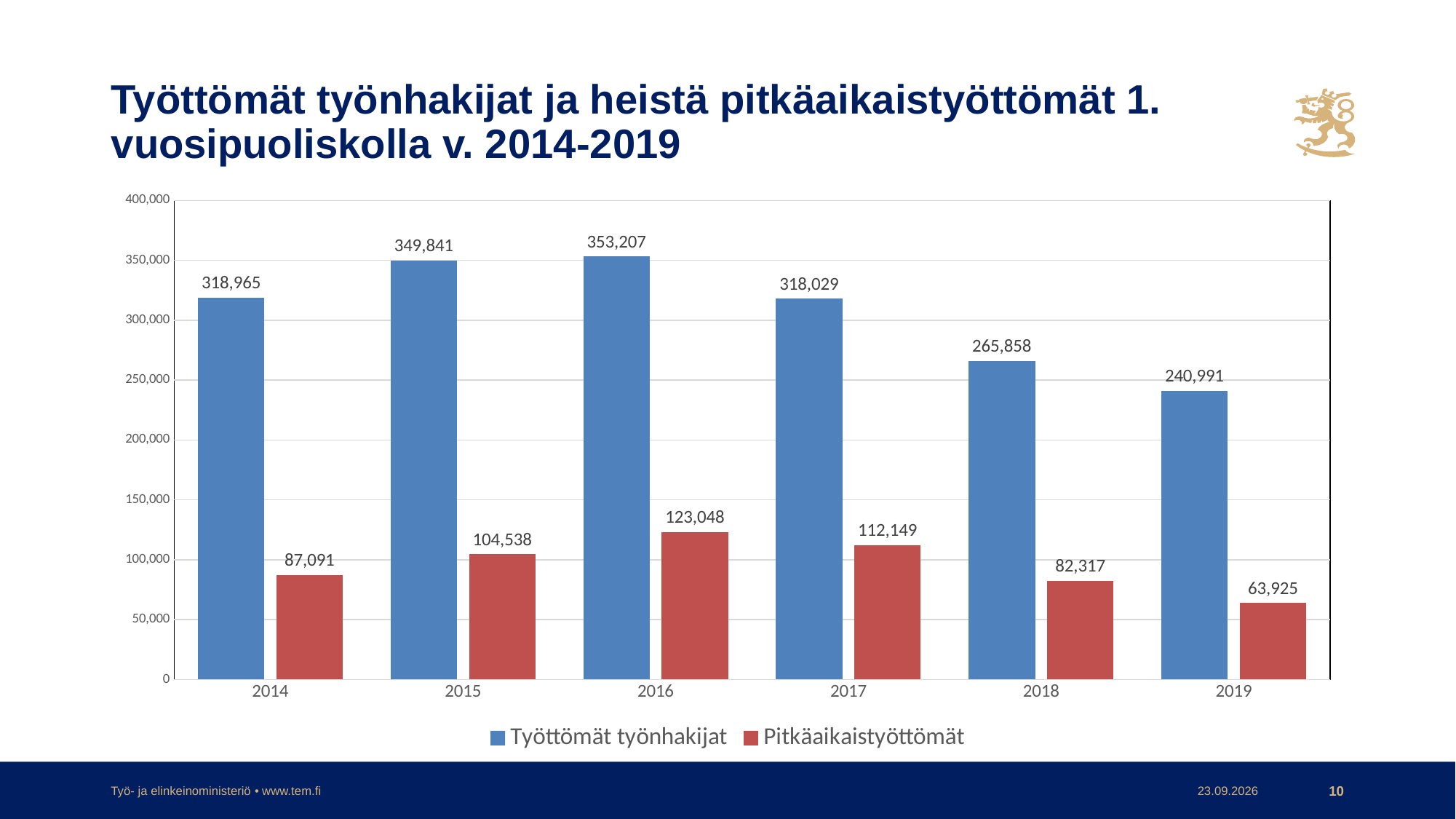
In which year is the value for Työttömät työnhakijat highest? 2016 What is the value for Pitkäaikaistyöttömät in 2019? 63,925 In which year is the value for Pitkäaikaistyöttömät lowest? 2019 By how much did Pitkäaikaistyöttömät fall from 2018 to 2019? 18,392 What is the value for Työttömät työnhakijat in 2016? 353,207 Which is larger: Työttömät työnhakijat in 2014 or in 2017? 2014 How many series does the legend list? 2 What is the value for Pitkäaikaistyöttömät in 2014? 87,091 What is the difference between Työttömät työnhakijat and Pitkäaikaistyöttömät in 2016? 230,159 What kind of chart is shown on the slide? Bar chart Do the values for Työttömät työnhakijat rise or fall from 2016 to 2019? Fall How many years are shown on the x axis? 6